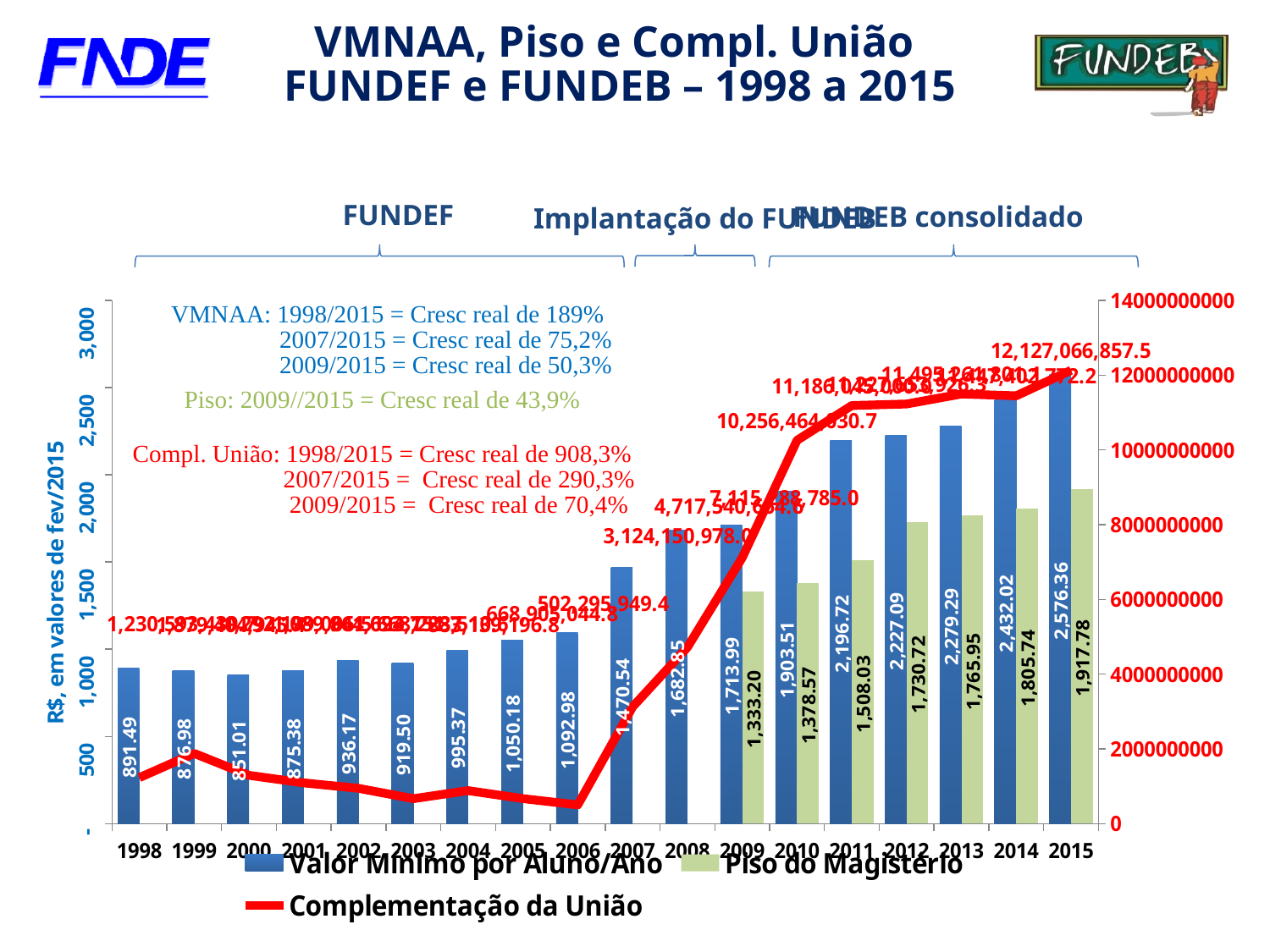
What is the Piso do Magistério value for 2015? 1,917.78 What is the difference between the Valor Mínimo por Aluno/Ano in 2015 and in 2014? 144.34 What is the Valor Mínimo por Aluno/Ano for 1998? 891.49 How many years are shown on the x axis of the chart? 18 How many series does the chart legend list? 3 In which year is the Valor Mínimo por Aluno/Ano highest? 2015 What is the Complementação da União value labelled for 2015? 12,127,066,857.5 In 2011, which is larger: the Valor Mínimo por Aluno/Ano or the Piso do Magistério? Valor Mínimo por Aluno/Ano In which year is the Valor Mínimo por Aluno/Ano lowest? 2000 What is the Valor Mínimo por Aluno/Ano for 2015? 2,576.36 What is the Piso do Magistério value for 2009? 1,333.20 Does the Piso do Magistério rise or fall from 2009 to 2015? Rises